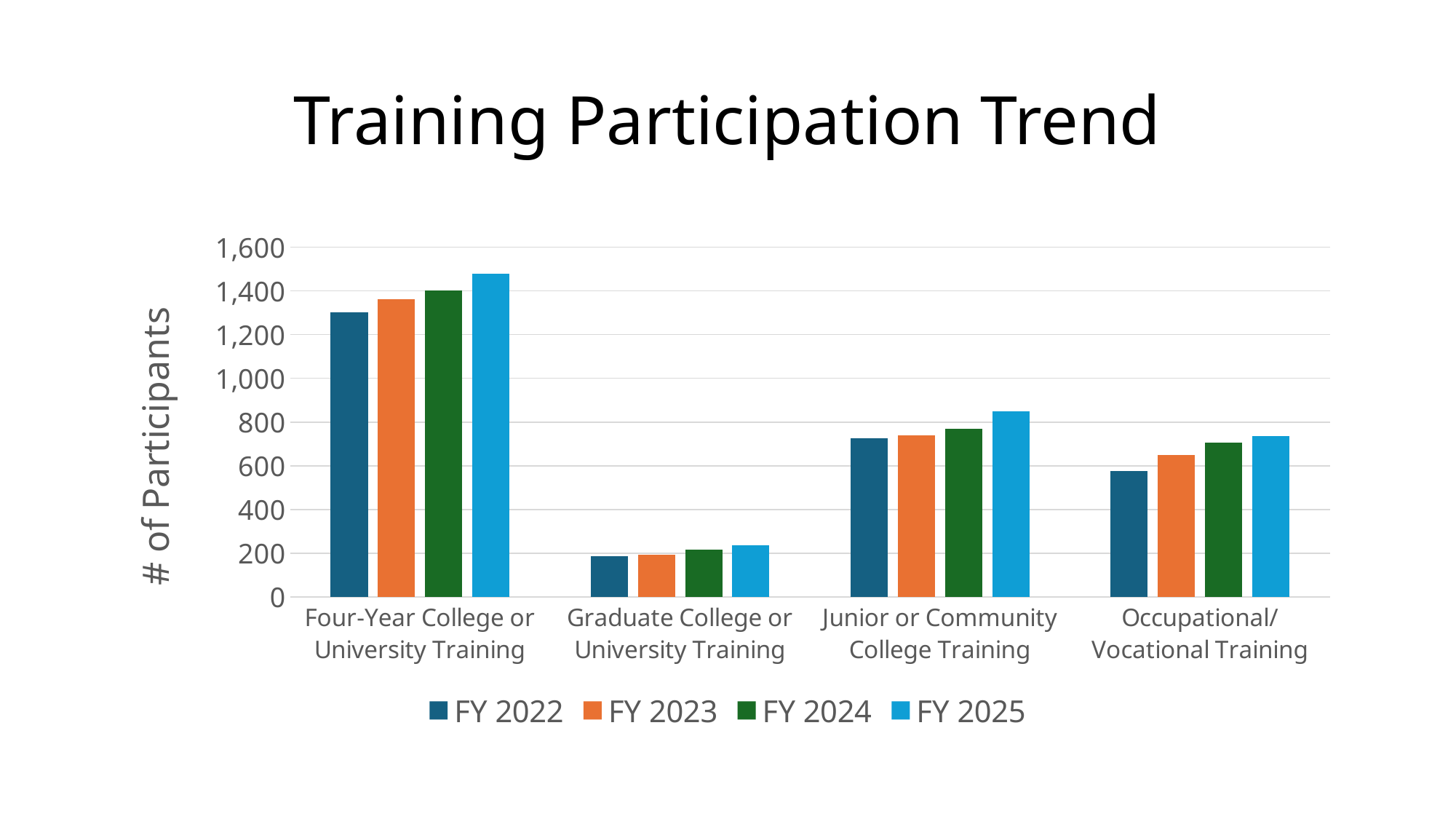
Is the FY 2022 value for Occupational/Vocational Training greater or less than 600? less Which training category has the highest number of participants? Four-Year College or University Training Is the FY 2025 value for Junior or Community College Training greater or less than 800? greater Which is larger: the FY 2025 value for Junior or Community College Training or the FY 2025 value for Occupational/Vocational Training? Junior or Community College Training Within each training category, do the values rise or fall from FY 2022 to FY 2025? Rise Which training category has the lowest number of participants? Graduate College or University Training How many series does the legend list? 4 What is the title of the y axis? # of Participants What kind of chart is shown on the slide? Bar chart How many training categories are shown on the x axis? 4 Is the FY 2025 value for Four-Year College or University Training greater or less than 1,400? greater Within Four-Year College or University Training, which fiscal year has the highest number of participants? FY 2025